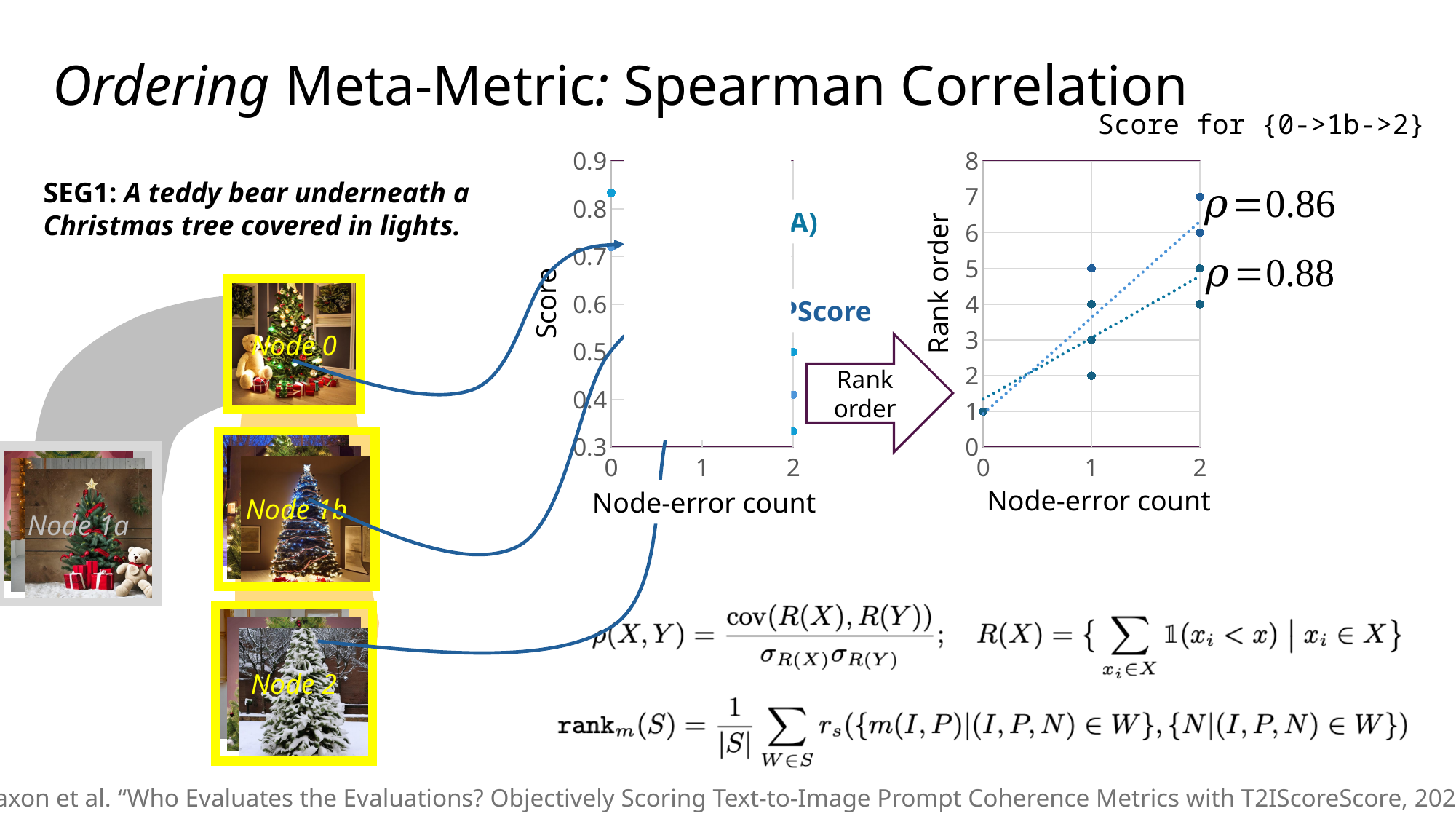
In the right-hand 'Rank order' chart, how many distinct node-error count values are shown on the x axis? 3 In the right-hand 'Rank order' chart, what is the label on the x axis? Node-error count In the right-hand 'Rank order' chart, does rank order rise or fall as node-error count increases? rise In the left-hand 'Score' chart, is the score at node-error count 0 greater or less than 0.7? greater Of the two Spearman correlation values annotated on the right-hand chart, ρ=0.86 and ρ=0.88, which is larger? ρ=0.88 In the left-hand chart, what is the label on the y axis? Score In the right-hand 'Rank order' chart, what is the highest rank order plotted? 7 In the right-hand 'Rank order' chart, what is the lowest rank order plotted? 1 In the right-hand 'Rank order' chart, is the rank order at node-error count 0 greater or less than 2? less What kind of chart is the right-hand chart with the y axis labelled 'Rank order'? scatter plot In the left-hand 'Score' chart, are the scores at node-error count 2 greater or less than 0.6? less